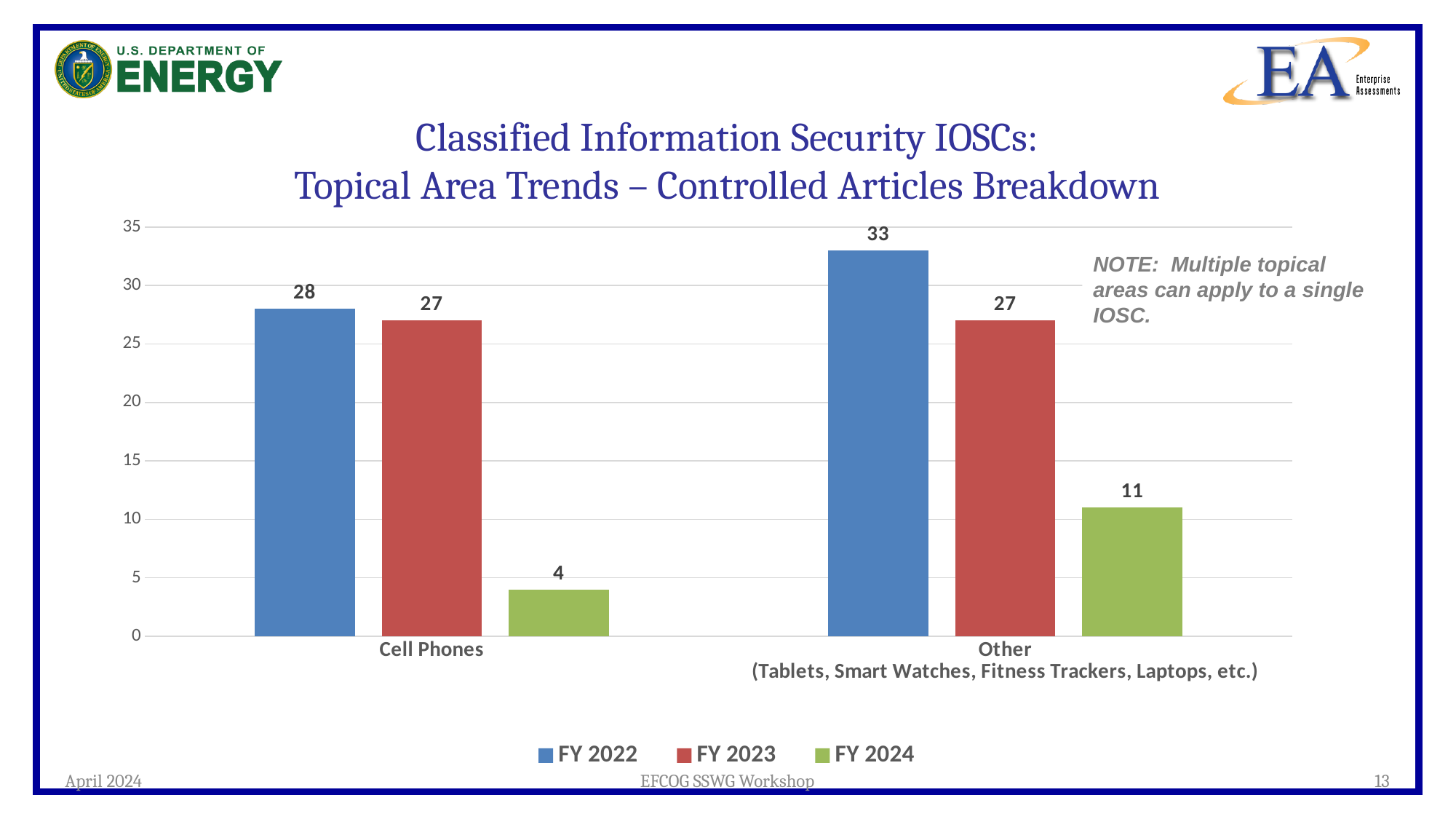
Which category has the highest FY 2022 value? Other What is the FY 2023 value for Cell Phones? 27 How many categories are shown on the x axis? 2 Which is larger, the FY 2024 value for Cell Phones or the FY 2024 value for Other? Other Which colour represents FY 2023 in the legend? Red What is the FY 2022 value for Cell Phones? 28 How many series does the legend list? 3 What kind of chart is shown on the slide? Bar chart Which series has the lowest value for Cell Phones? FY 2024 What is the FY 2024 value for Other (Tablets, Smart Watches, Fitness Trackers, Laptops, etc.)? 11 What is the difference between the FY 2022 values for Other and Cell Phones? 5 What is the difference between the FY 2022 and FY 2024 values for Cell Phones? 24